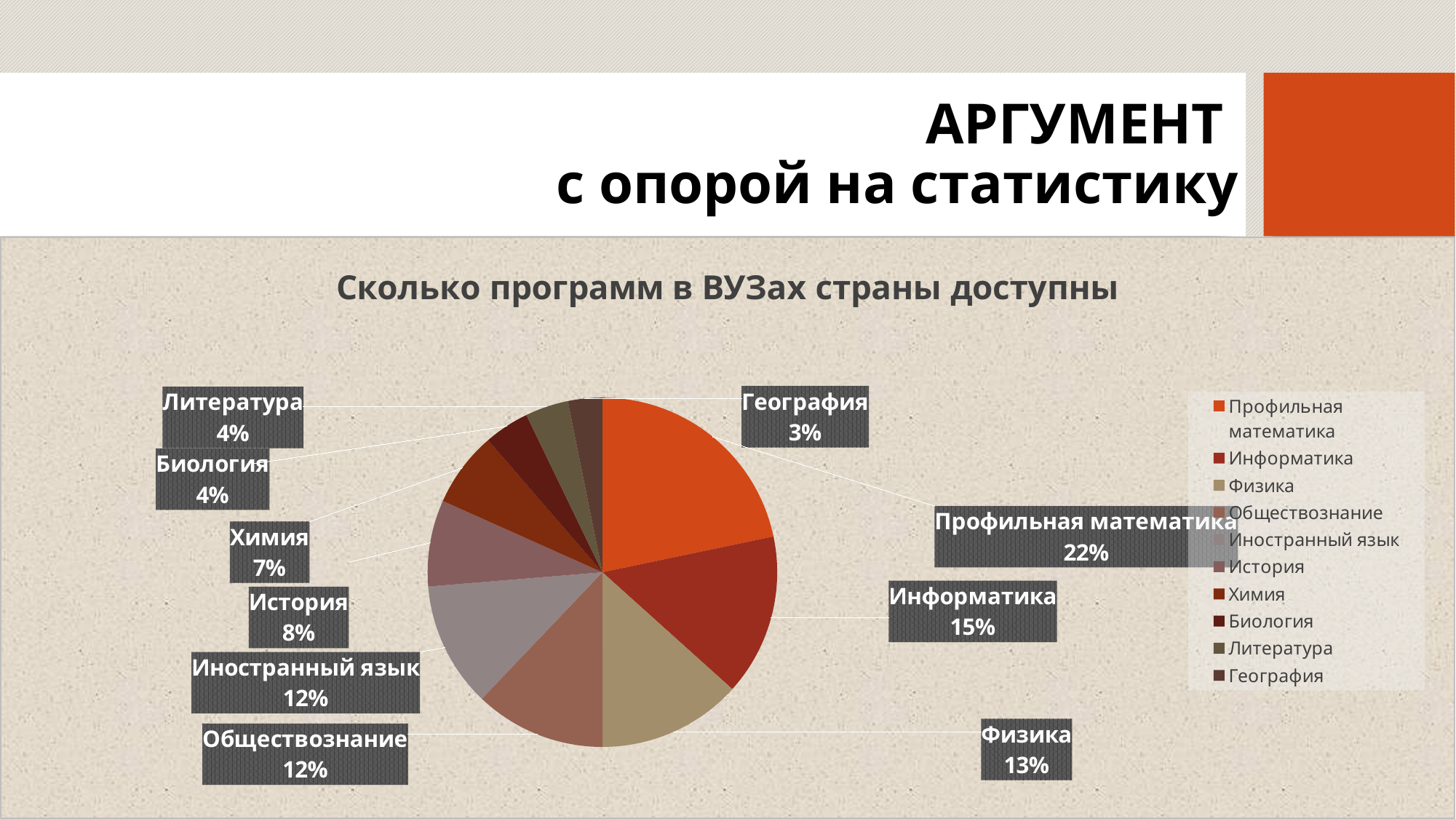
What is the value shown for Физика? 13% What is the value shown for Информатика? 15% What is the difference between the values for Обществознание and Биология? 8% What is the value shown for История? 8% Which is larger, the value for Химия or the value for История? История What kind of chart is shown on the slide? Pie chart How many categories are shown in the pie chart? 10 Which category has the smallest slice of the pie? География What is the title of the chart? Сколько программ в ВУЗах страны доступны What is the difference between the values for Профильная математика and Информатика? 7% What share of the pie does Профильная математика have? 22% Which category has the largest slice of the pie? Профильная математика